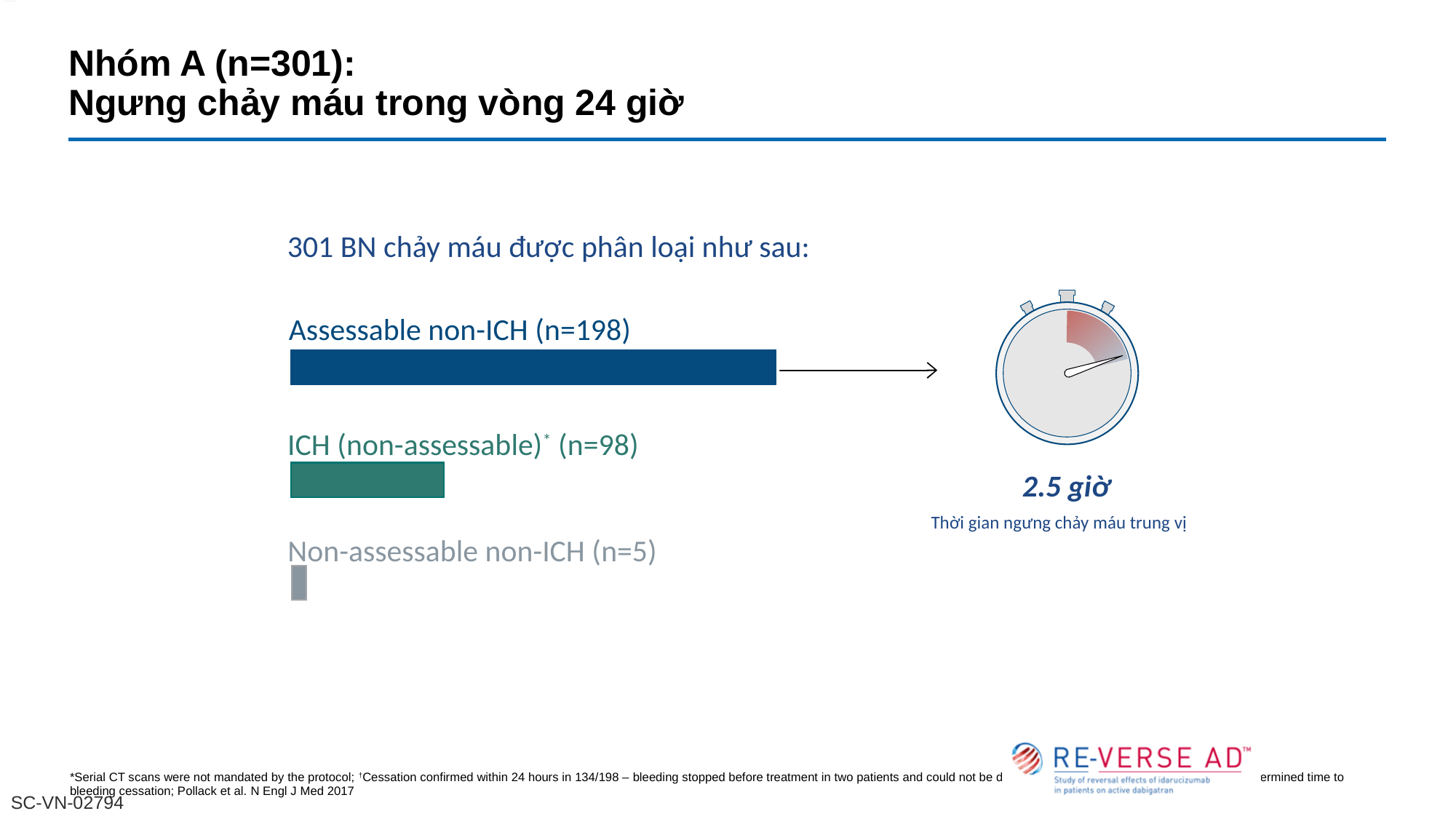
What is the value (n) for ICH (non-assessable)? 98 Which category has the highest value? Assessable non-ICH What is the difference between the values for Assessable non-ICH and ICH (non-assessable)? 100 What is the total of the three category values shown in the bar chart? 301 Which is larger, the value for ICH (non-assessable) or the value for Non-assessable non-ICH? ICH (non-assessable) What colour is the bar for ICH (non-assessable)? green What kind of chart is shown on the slide? bar chart What median time to bleeding cessation is shown next to the stopwatch? 2.5 giờ Which category has the lowest value? Non-assessable non-ICH What is the value (n) for Assessable non-ICH? 198 How many categories does the bar chart show? 3 What is the value (n) for Non-assessable non-ICH? 5